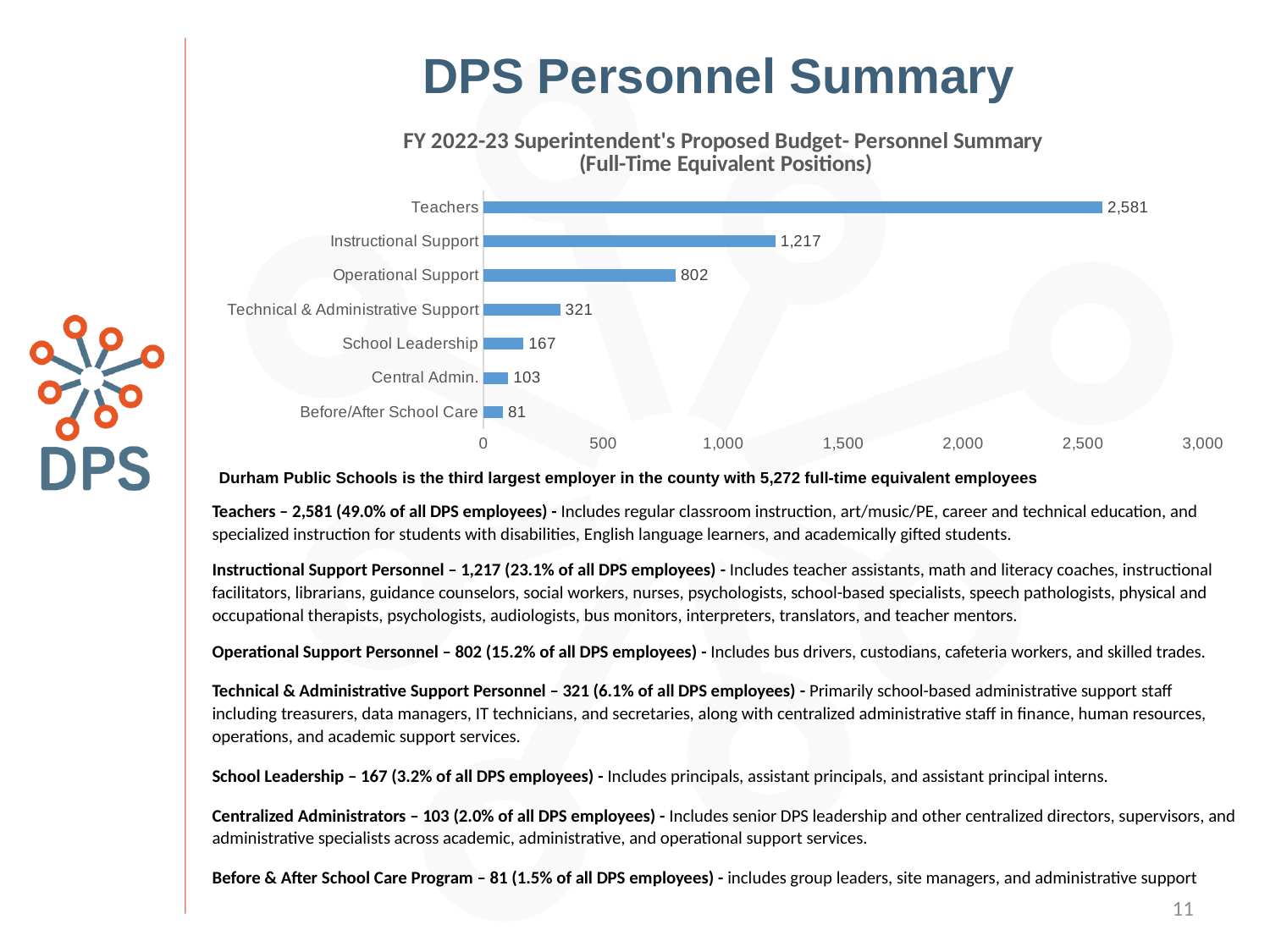
What is the value for Teachers? 2,581 What is the difference between the values for Teachers and Instructional Support? 1,364 What is the value for Central Admin.? 103 What kind of chart is shown on the slide? Bar chart What is the title of the chart? FY 2022-23 Superintendent's Proposed Budget- Personnel Summary (Full-Time Equivalent Positions) How many categories are shown in the chart? 7 Which category has the highest value? Teachers Is the value for Instructional Support greater or less than 1,000? greater Which is larger, the value for Operational Support or the value for Technical & Administrative Support? Operational Support What is the difference between the values for School Leadership and Central Admin.? 64 Which category has the lowest value? Before/After School Care What is the value for Operational Support? 802